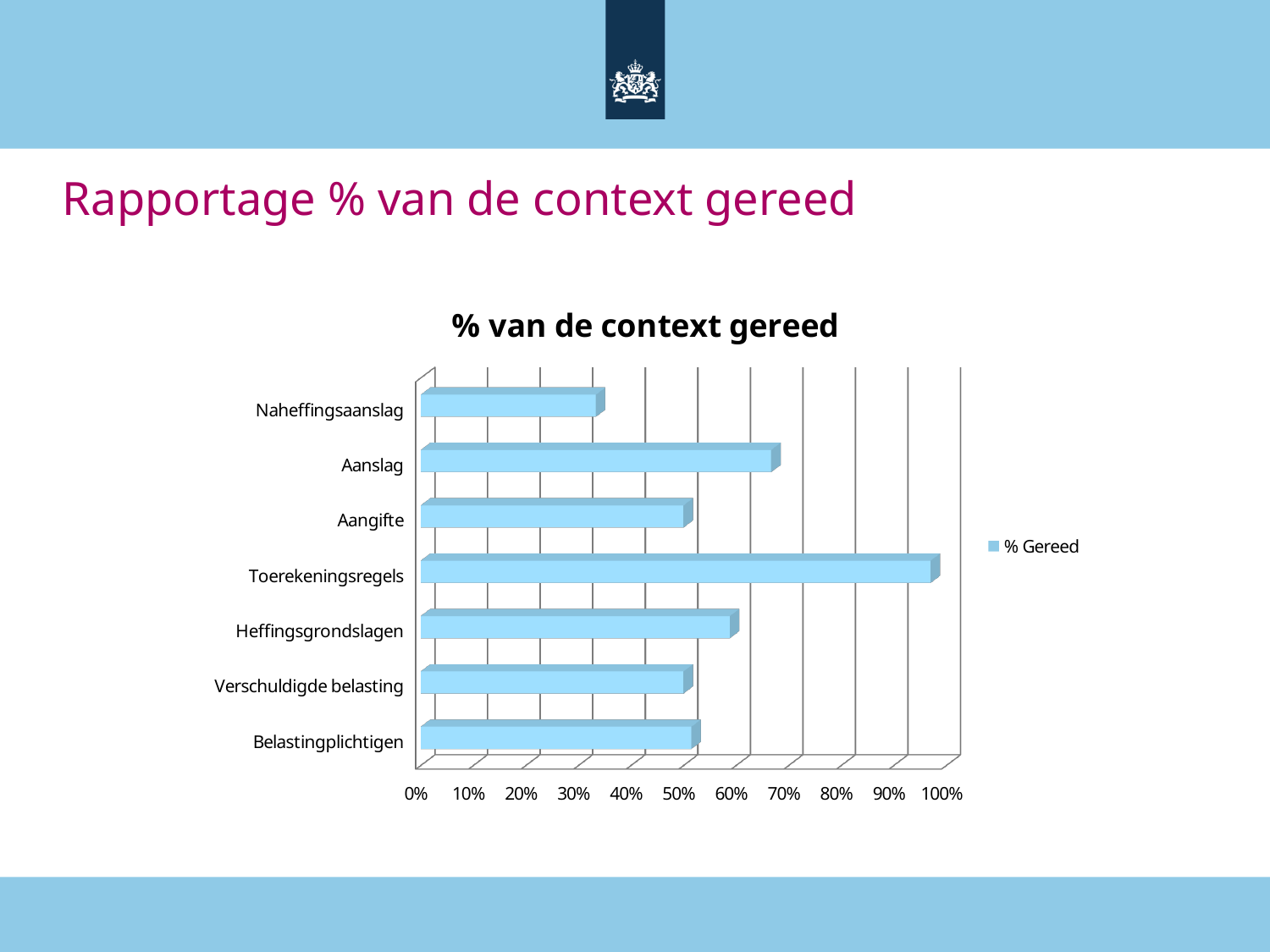
What kind of chart is shown on the slide? bar chart What series name is shown in the legend? % Gereed Which is larger, the value for Aanslag or the value for Aangifte? Aanslag How many series does the legend list? 1 Which category has the lowest % Gereed value? Naheffingsaanslag Is the value for Toerekeningsregels greater or less than 90%? greater What is the title of the chart? % van de context gereed Is the value for Heffingsgrondslagen greater or less than 70%? less Is the value for Aanslag greater or less than 60%? greater Which category has the highest % Gereed value? Toerekeningsregels How many categories are plotted in the chart? 7